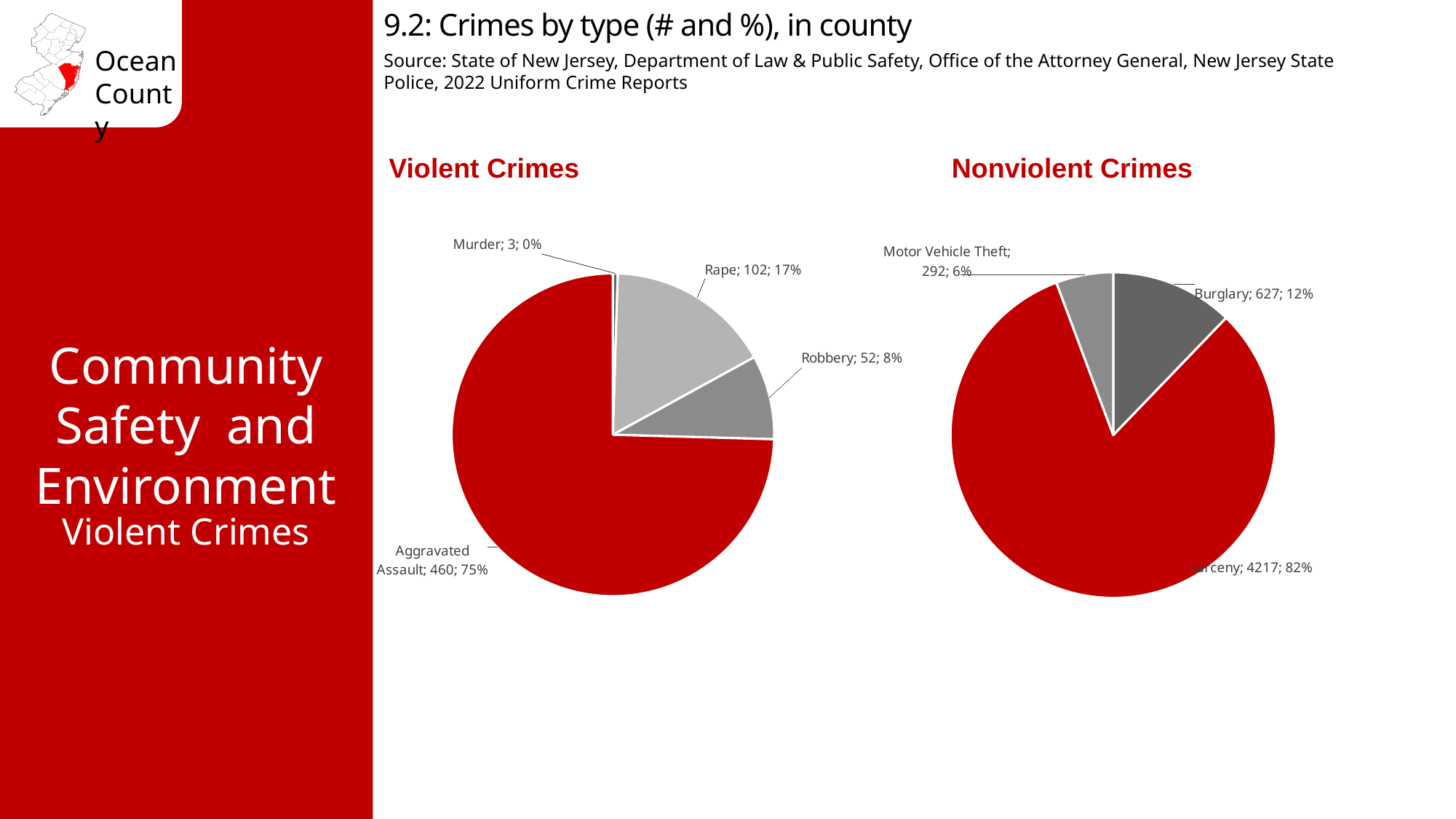
In the Violent Crimes chart, which category has the smallest slice? Murder In the Violent Crimes chart, what percentage share does Rape have? 17% In the Nonviolent Crimes chart, which is larger, Burglary or Motor Vehicle Theft? Burglary In the Nonviolent Crimes chart, which category has the largest slice? Larceny In the Nonviolent Crimes chart, how many larcenies are shown? 4217 What type of chart is used for the Violent Crimes chart? Pie chart In the Nonviolent Crimes chart, what percentage share does Burglary have? 12% In the Violent Crimes chart, what is the difference between the Rape count and the Robbery count? 50 In the Nonviolent Crimes chart, how many categories are shown? 3 In the Violent Crimes chart, how many categories are shown? 4 In the Violent Crimes chart, how many aggravated assaults are shown? 460 In the Nonviolent Crimes chart, what is the difference between the Burglary count and the Motor Vehicle Theft count? 335